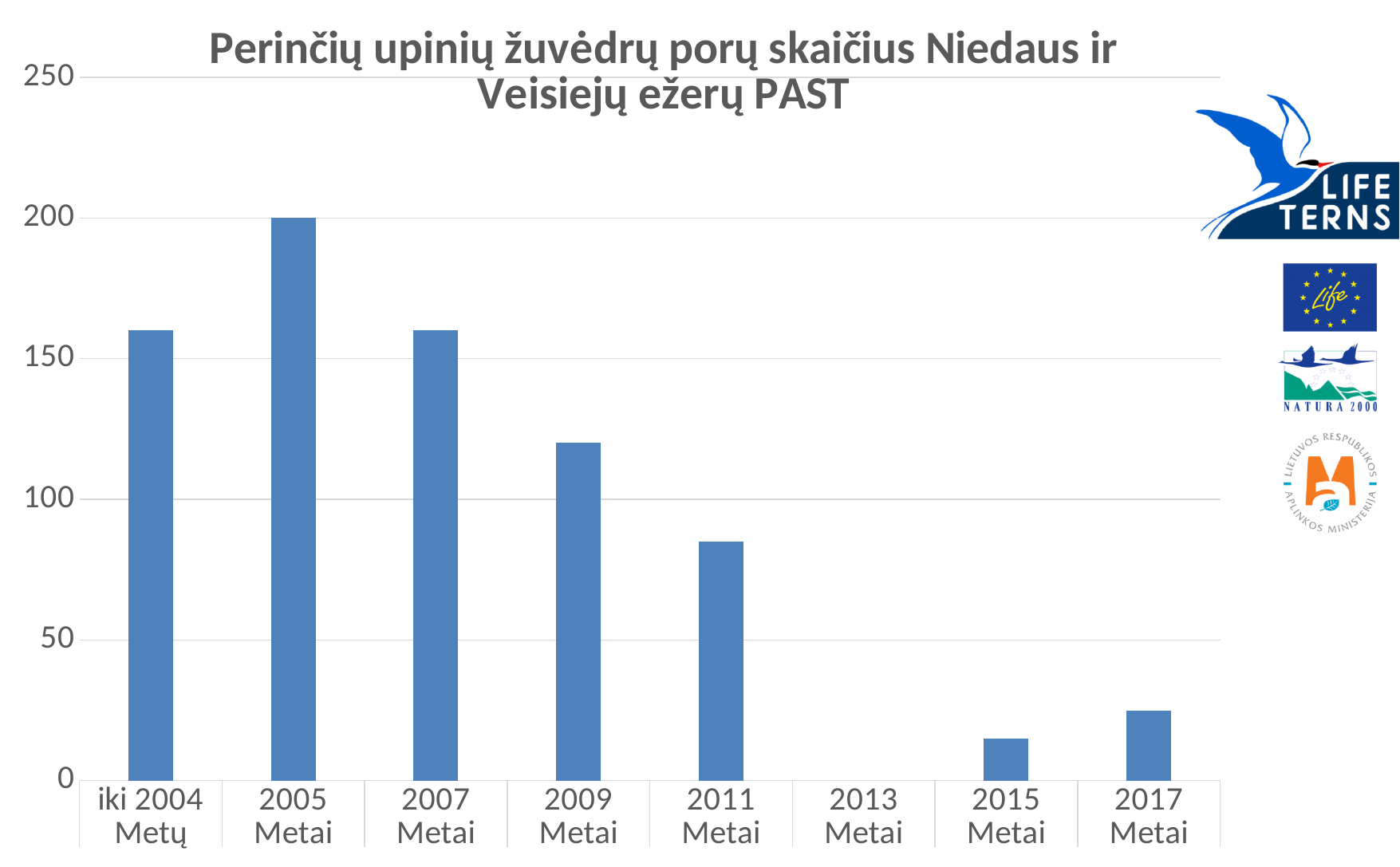
What is the value for 2005 Metai? 200 Which is larger, the value for 2007 Metai or 2009 Metai? 2007 Metai Do the values rise or fall from 2005 Metai to 2013 Metai? fall How many categories are shown on the x axis? 8 What is the title of the chart? Perinčių upinių žuvėdrų porų skaičius Niedaus ir Veisiejų ežerų PAST Is the value for iki 2004 Metų greater or less than 150? greater Is the value for 2011 Metai greater or less than 100? less Which category has the highest value? 2005 Metai What kind of chart is shown on the slide? bar chart Is the value for 2017 Metai greater or less than 50? less